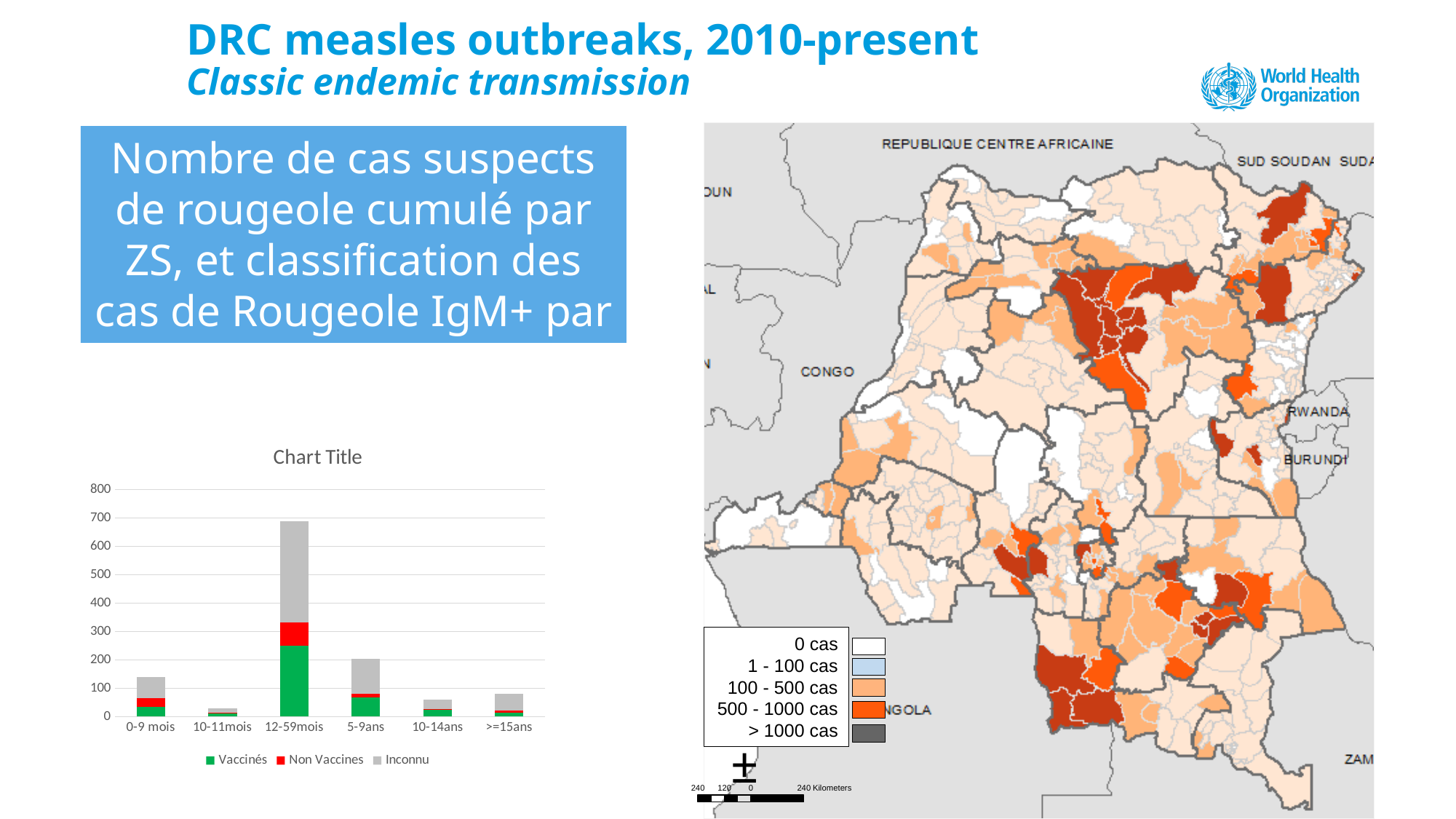
How many age categories are shown on the x axis of the bar chart? 6 Is the total value of the stacked bar for 12-59mois greater or less than 600? greater How many series does the legend of the bar chart list? 3 What kind of chart is shown on the slide? stacked bar chart What is the title shown above the bar chart? Chart Title Which colour represents the Inconnu series in the bar chart? grey Is the total value of the stacked bar for 0-9 mois greater or less than 100? greater Is the total value of the stacked bar for 10-11mois greater or less than 100? less Which stacked bar is taller, 0-9 mois or 5-9ans? 5-9ans Which age category has the shortest stacked bar in the chart? 10-11mois Which age category has the tallest stacked bar in the chart? 12-59mois